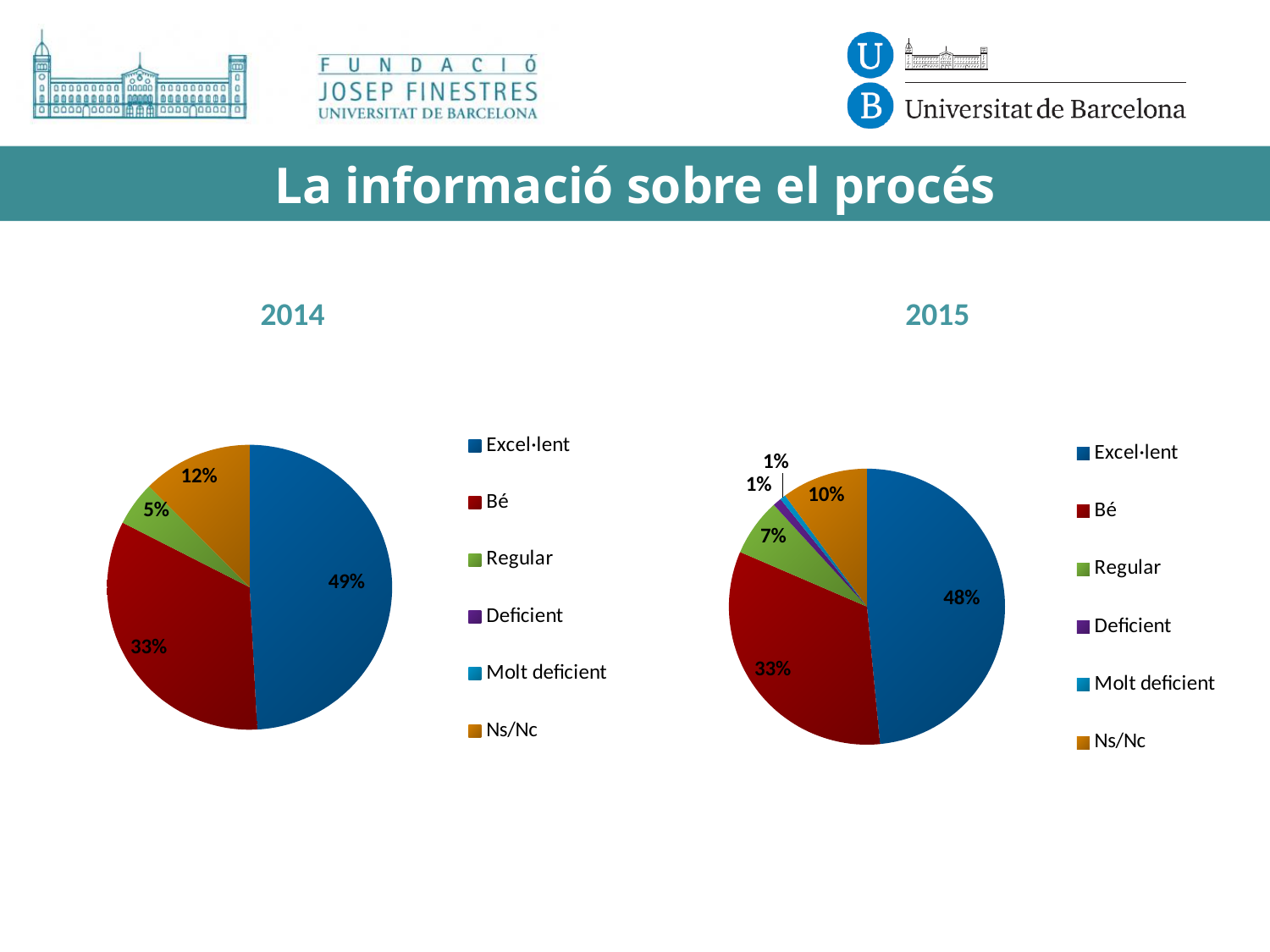
In the 2014 pie chart, what share does Excel·lent have? 49% In the 2015 pie chart, what share does Ns/Nc have? 10% In the 2014 pie chart, which category has the largest slice? Excel·lent In the 2015 pie chart, which category has the largest slice? Excel·lent In the 2014 pie chart, what is the difference between the Excel·lent and Bé shares? 16% How many entries does the legend of the 2015 pie chart list? 6 What kind of chart is used for the 2014 data? Pie chart In the 2015 pie chart, what share does Excel·lent have? 48% In the 2014 pie chart, what share does Bé have? 33% In the 2015 pie chart, what share does Regular have? 7% In the 2014 pie chart, what share does Ns/Nc have? 12% In the 2015 pie chart, which is larger, Regular or Ns/Nc? Ns/Nc